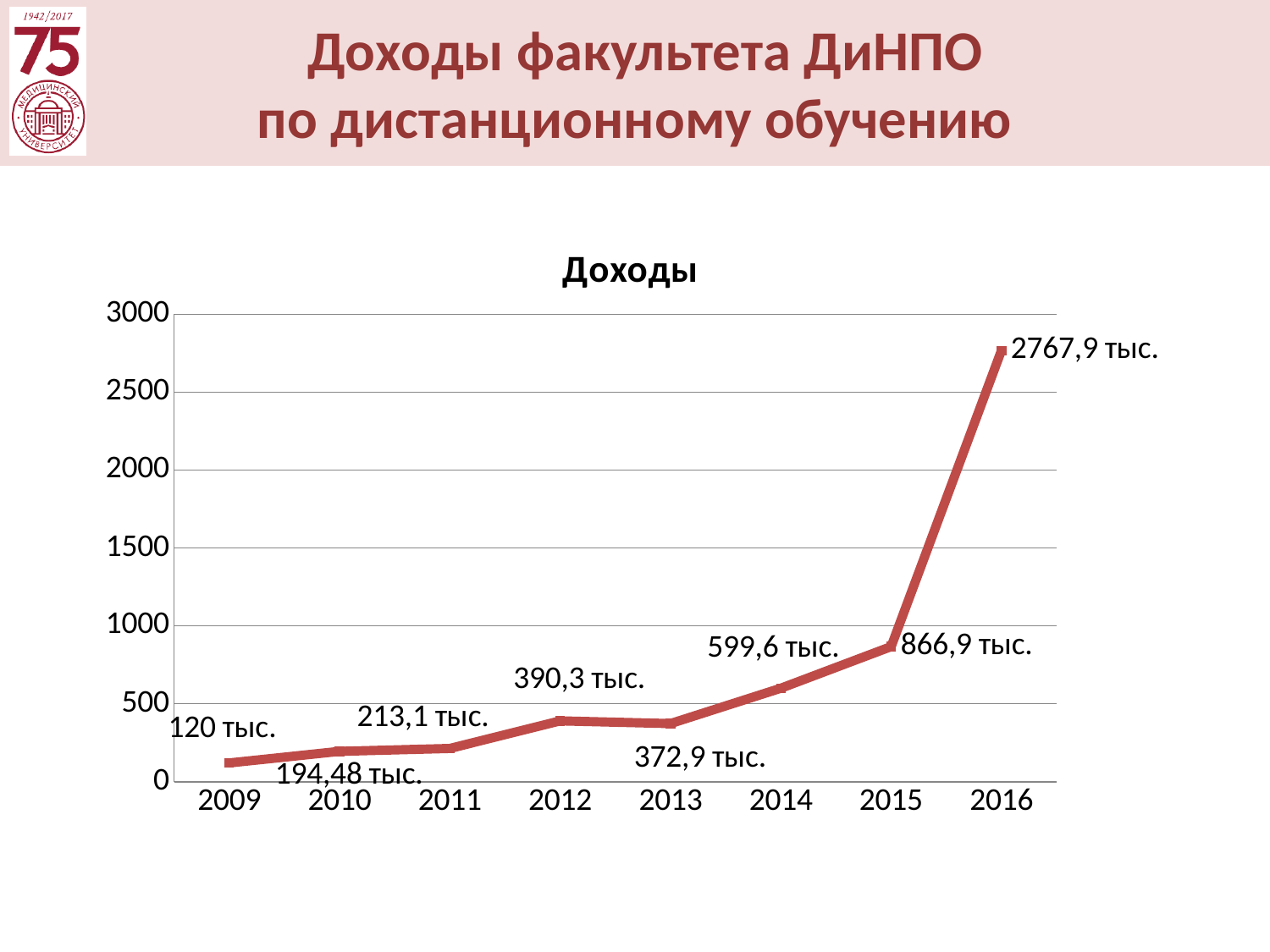
What kind of chart is shown on the slide? line chart How many years are plotted on the Доходы chart? 8 What is the value for 2013 on the Доходы chart? 372,9 тыс. What is the value for 2009 on the Доходы chart? 120 тыс. What is the difference between the values for 2016 and 2015 on the Доходы chart? 1901 тыс. Is the value for 2015 on the Доходы chart greater or less than 1000? less Which year has the highest value on the Доходы chart? 2016 What is the value for 2010 on the Доходы chart? 194,48 тыс. Which year has the lowest value on the Доходы chart? 2009 What is the difference between the values for 2014 and 2013 on the Доходы chart? 226,7 тыс. Which is larger on the Доходы chart, the value for 2012 or the value for 2013? 2012 What is the value for 2016 on the Доходы chart? 2767,9 тыс.